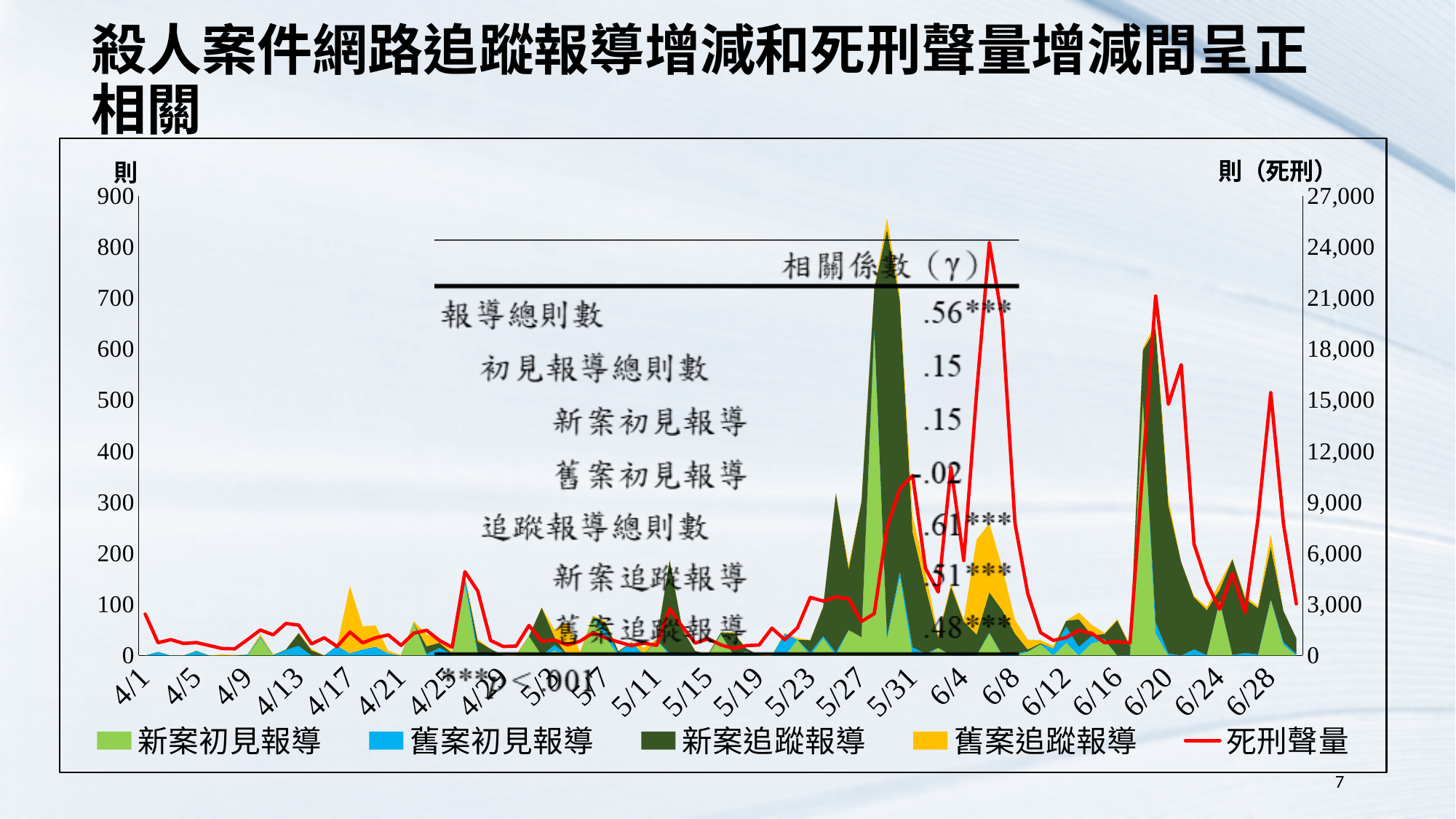
What kind of chart is shown on the slide? area chart with a line What is the highest tick value on the right-hand axis? 27,000 How many date labels are shown on the x axis? 23 What is the highest tick value on the left-hand axis? 900 Which series is drawn as a red line? 死刑聲量 How many series does the legend list? 5 What is the label of the right-hand vertical axis? 則（死刑） Is the value of 死刑聲量 on 4/1 greater or less than 6,000? less Which peak of 死刑聲量 is higher: the one between 6/4 and 6/8 or the one near 6/20? the one between 6/4 and 6/8 Is the highest peak of 死刑聲量 (between 6/4 and 6/8) greater or less than 21,000? greater Does 死刑聲量 rise or fall from 6/20 to 6/24? fall Is the highest stacked total of the report series (between 5/27 and 5/31) greater or less than 600? greater